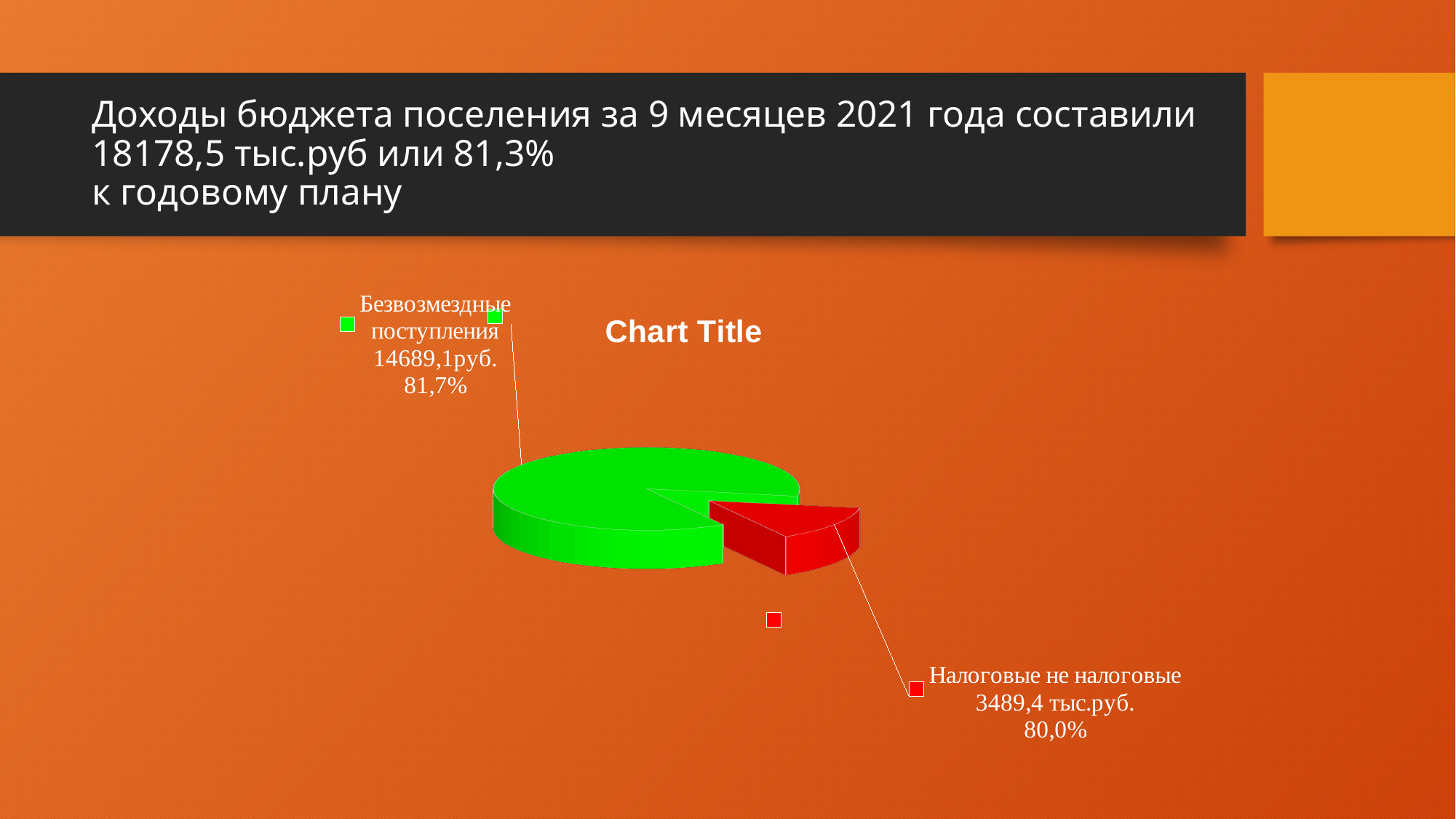
What percentage is printed in the data label for Налоговые не налоговые? 80,0% Which slice of the pie chart is the largest? Безвозмездные поступления What is the title shown above the pie chart? Chart Title Which is larger, the amount for Безвозмездные поступления or the amount for Налоговые не налоговые? Безвозмездные поступления What amount is printed in the data label for Безвозмездные поступления? 14689,1руб. Is the amount for Налоговые не налоговые greater or less than 5000? less How many slices does the pie chart have? 2 What colour is the slice for Налоговые не налоговые? red What kind of chart is shown on the slide? pie chart Which slice of the pie chart is the smallest? Налоговые не налоговые What amount is printed in the data label for Налоговые не налоговые? 3489,4 тыс.руб. What percentage is printed in the data label for Безвозмездные поступления? 81,7%